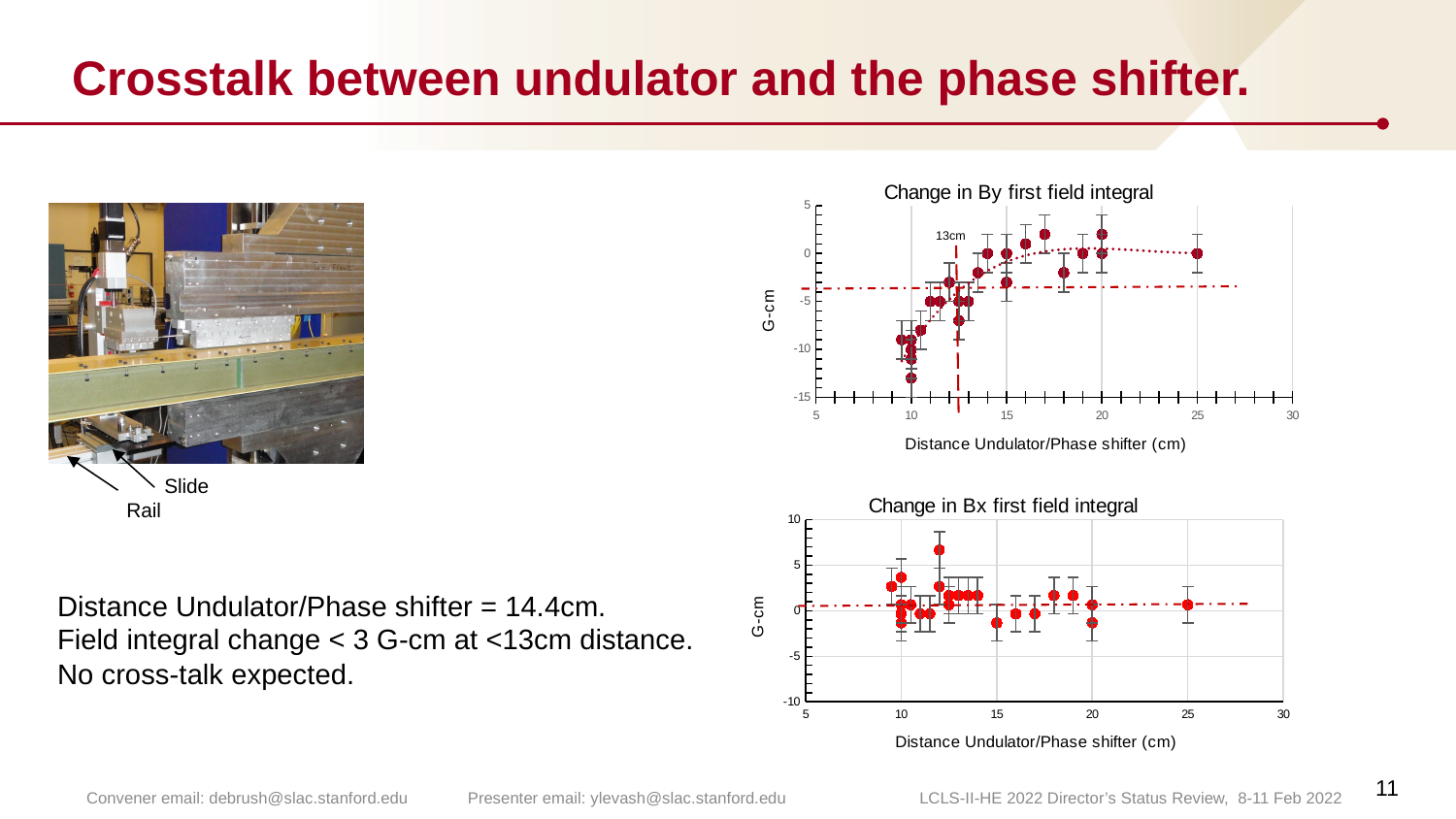
In the 'Change in Bx first field integral' chart, is the value at 25 cm distance greater or less than 5 G-cm? less In the 'Change in By first field integral' chart, is the value at 25 cm distance greater or less than -5 G-cm? greater What is the x-axis label of the 'Change in Bx first field integral' chart? Distance Undulator/Phase shifter (cm) In the 'Change in By first field integral' chart, are the values at about 10 cm distance greater or less than -5 G-cm? less In the 'Change in By first field integral' chart, which is larger: the value at about 10 cm distance or the value at 25 cm distance? 25 cm What kind of chart is the 'Change in By first field integral' chart? scatter chart What is the lowest value shown on the y axis of the 'Change in By first field integral' chart? -15 What kind of chart is the 'Change in Bx first field integral' chart? scatter chart In the 'Change in By first field integral' chart, do the values rise or fall as the distance increases from 10 cm to 25 cm? rise